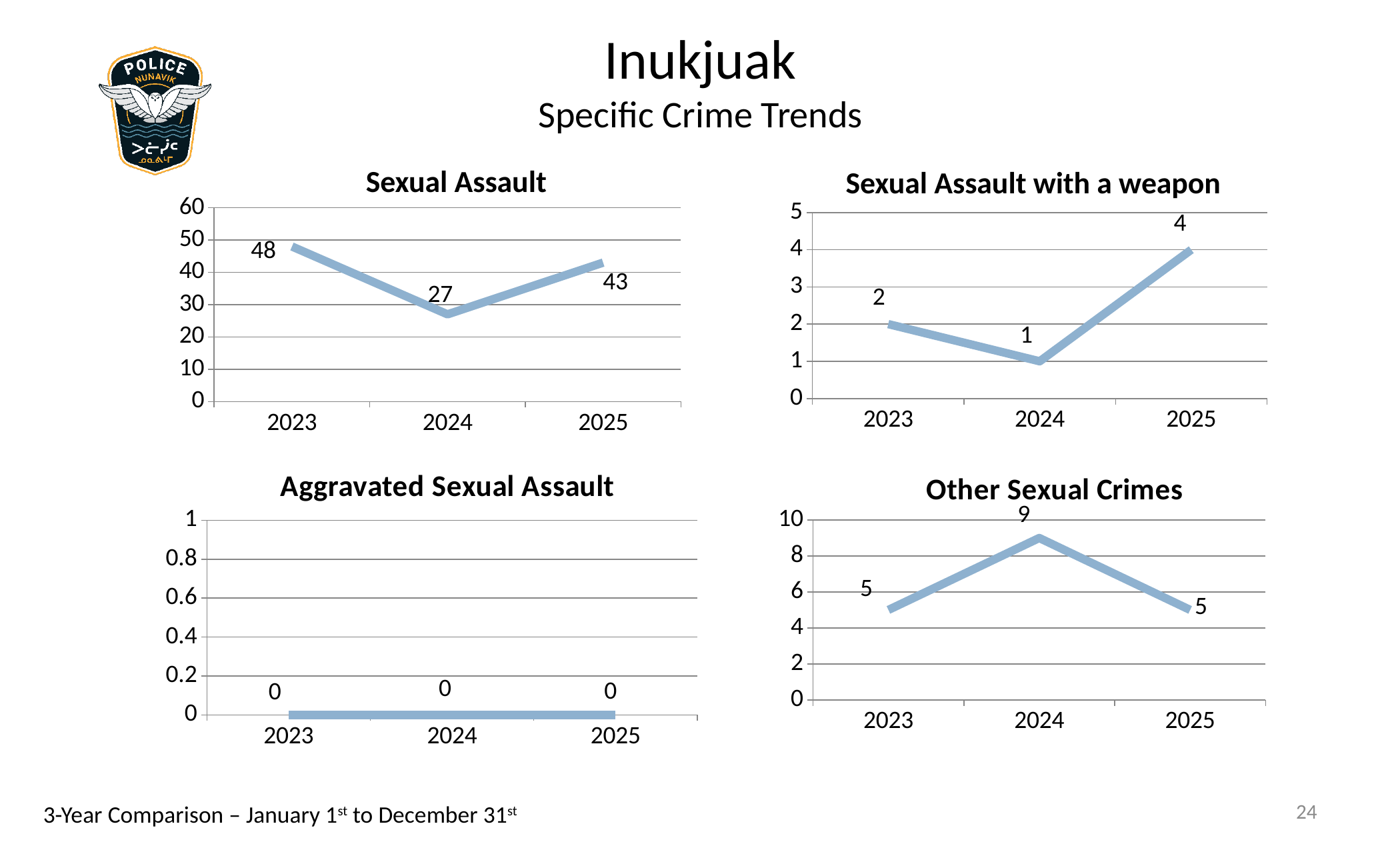
In the Sexual Assault with a weapon chart, is the value for 2023 larger or smaller than the value for 2025? smaller In the Other Sexual Crimes chart, what is the value for 2024? 9 In the Other Sexual Crimes chart, how many years are plotted on the x axis? 3 What kind of chart is the Sexual Assault chart? line chart In the Aggravated Sexual Assault chart, what is the value for 2024? 0 In the Sexual Assault with a weapon chart, what is the value for 2025? 4 In the Sexual Assault chart, do the values rise or fall from 2024 to 2025? rise In the Other Sexual Crimes chart, what is the difference between the 2024 and 2025 values? 4 In the Sexual Assault chart, which year has the highest value? 2023 In the Sexual Assault chart, what is the value for 2024? 27 In the Sexual Assault with a weapon chart, which year has the lowest value? 2024 In the Sexual Assault chart, what is the difference between the 2023 and 2025 values? 5